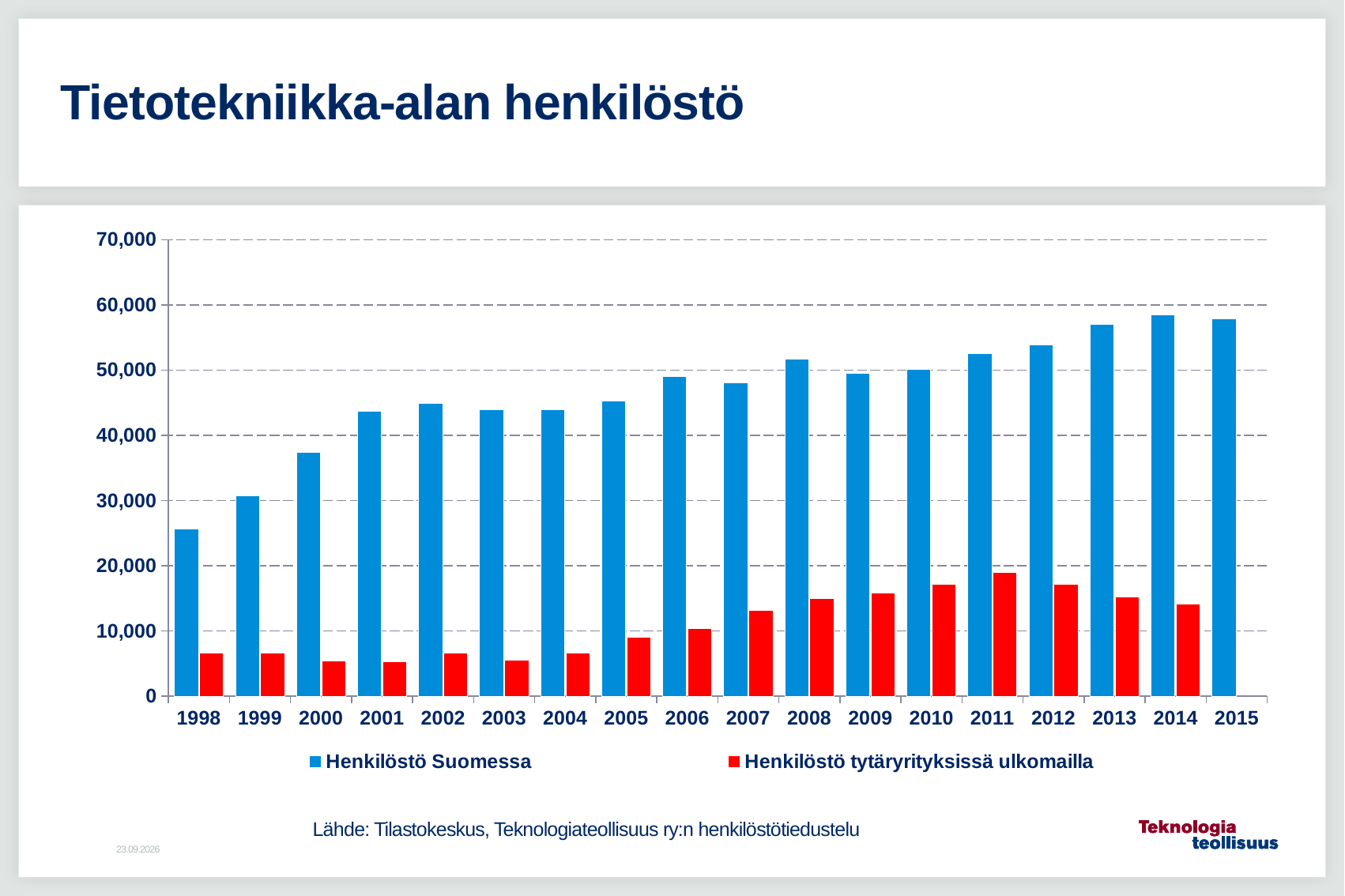
Is the value for Henkilöstö Suomessa in 2014 greater or less than 50,000? greater Overall, do the values for Henkilöstö Suomessa rise or fall from 1998 to 2015? rise How many years are shown on the x axis? 18 Which year has the lowest value for Henkilöstö Suomessa? 1998 Which year has the highest value for Henkilöstö tytäryrityksissä ulkomailla? 2011 How many series does the legend list? 2 Which is larger, Henkilöstö Suomessa in 2000 or Henkilöstö Suomessa in 2005? 2005 What colour are the bars for Henkilöstö tytäryrityksissä ulkomailla? red Is the value for Henkilöstö tytäryrityksissä ulkomailla in 2011 greater or less than 20,000? less Is the value for Henkilöstö tytäryrityksissä ulkomailla in 2007 greater or less than 10,000? greater What kind of chart is shown on the slide? bar chart